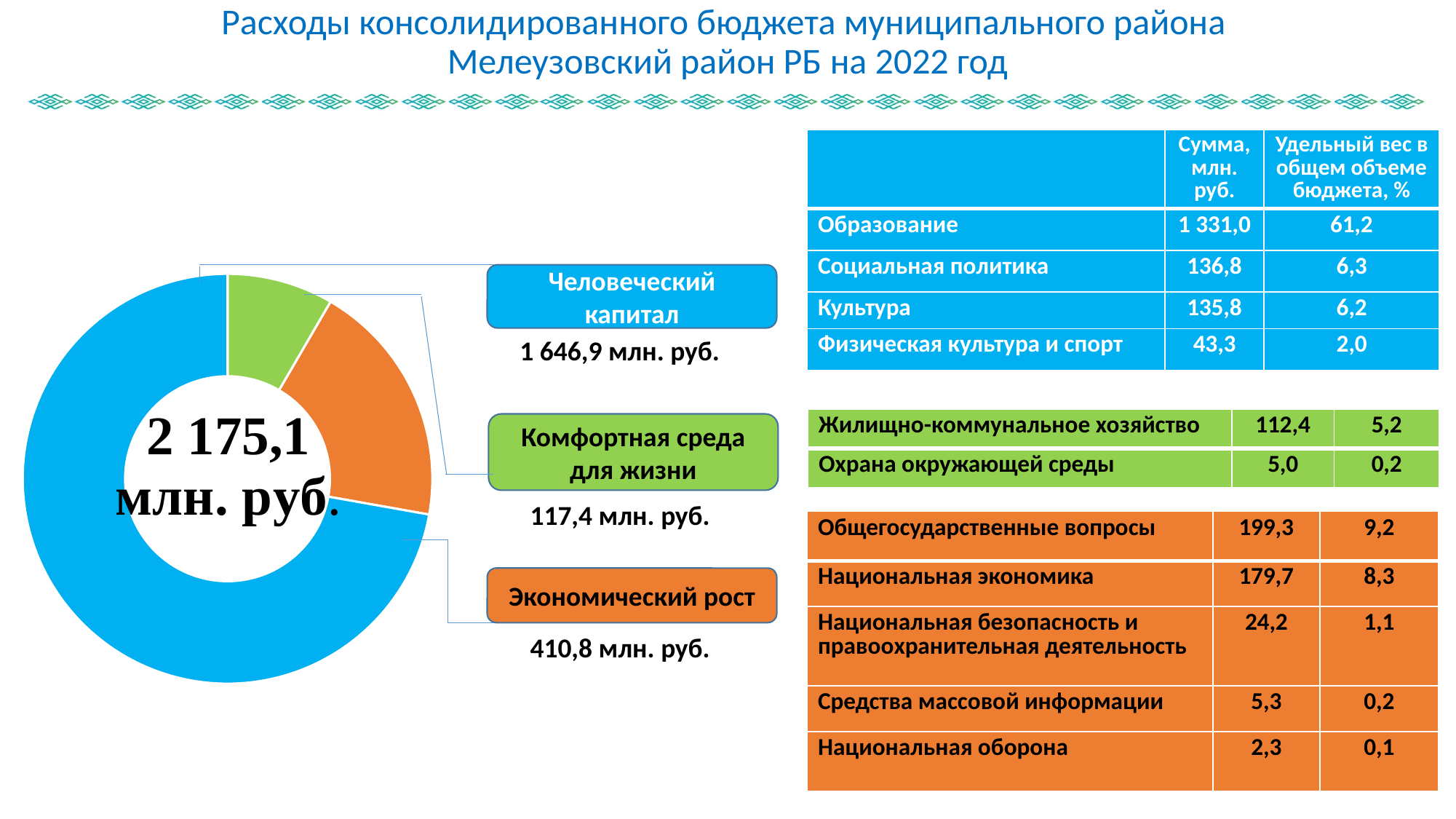
What colour is the Экономический рост segment of the donut chart? Orange What kind of chart is shown on the slide? Donut (pie) chart What is the value for Человеческий капитал in the donut chart? 1 646,9 млн. руб. What is the value for Экономический рост in the donut chart? 410,8 млн. руб. How many segments does the donut chart have? 3 Which segment of the donut chart is the smallest? Комфортная среда для жизни What is the difference between Экономический рост and Комфортная среда для жизни in the donut chart? 293,4 млн. руб. What is the value for Комфортная среда для жизни in the donut chart? 117,4 млн. руб. What is the difference between Человеческий капитал and Экономический рост in the donut chart? 1 236,1 млн. руб. What total value is shown in the centre of the donut chart? 2 175,1 млн. руб. Which is larger in the donut chart: Экономический рост or Комфортная среда для жизни? Экономический рост Which segment of the donut chart is the largest? Человеческий капитал